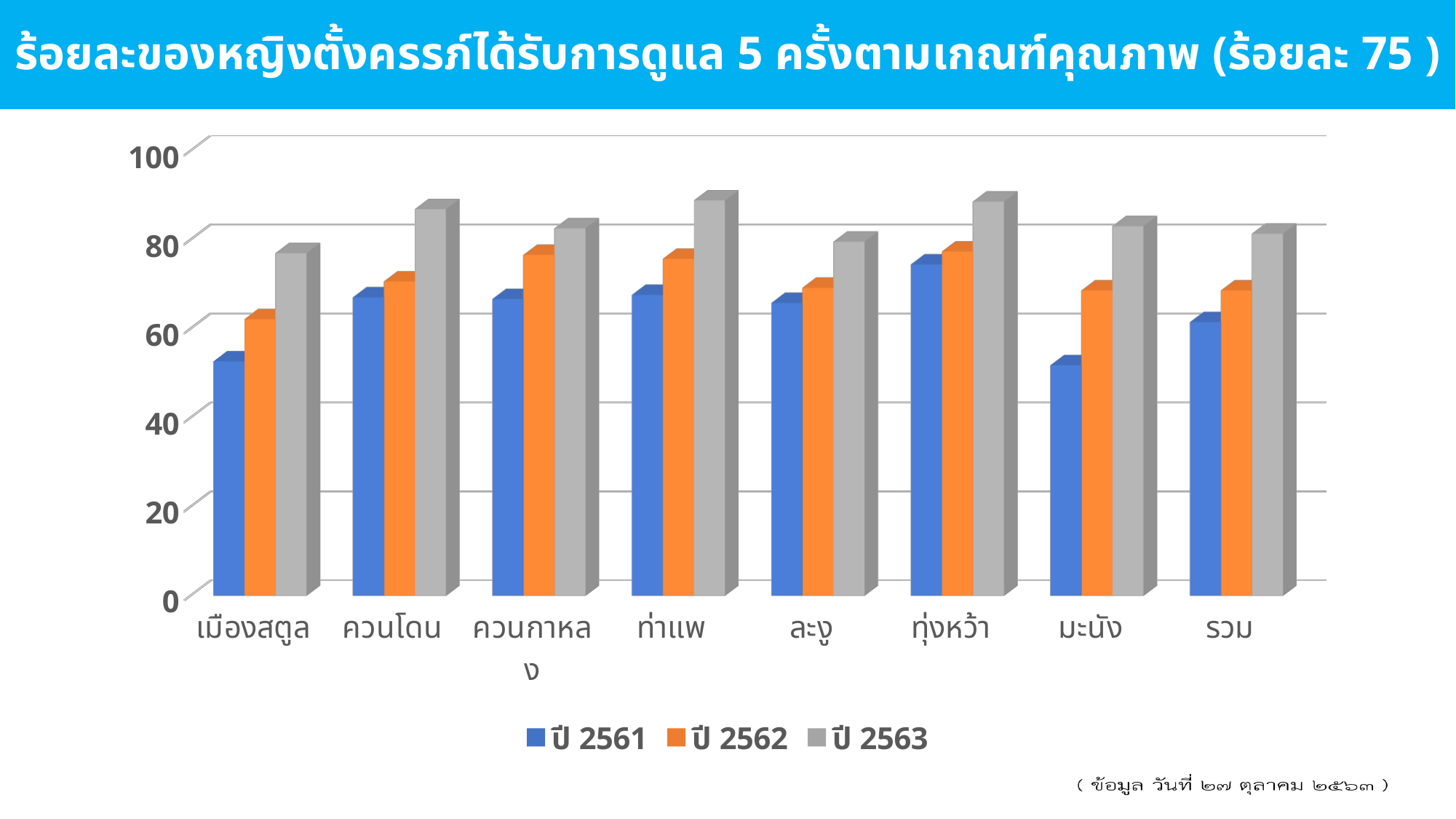
Which colour represents ปี 2563 in the legend? grey Is the value for ท่าแพ in ปี 2563 greater or less than 80? greater Is the value for รวม in ปี 2562 greater or less than 60? greater Is the value for เมืองสตูล in ปี 2561 greater or less than 60? less In ปี 2561, which is larger: the value for ทุ่งหว้า or the value for มะนัง? ทุ่งหว้า How many series does the legend list? 3 Which category has the lowest value in ปี 2562? เมืองสตูล How many categories are shown along the x axis? 8 What kind of chart is shown on the slide? bar chart Which category has the highest value in ปี 2561? ทุ่งหว้า